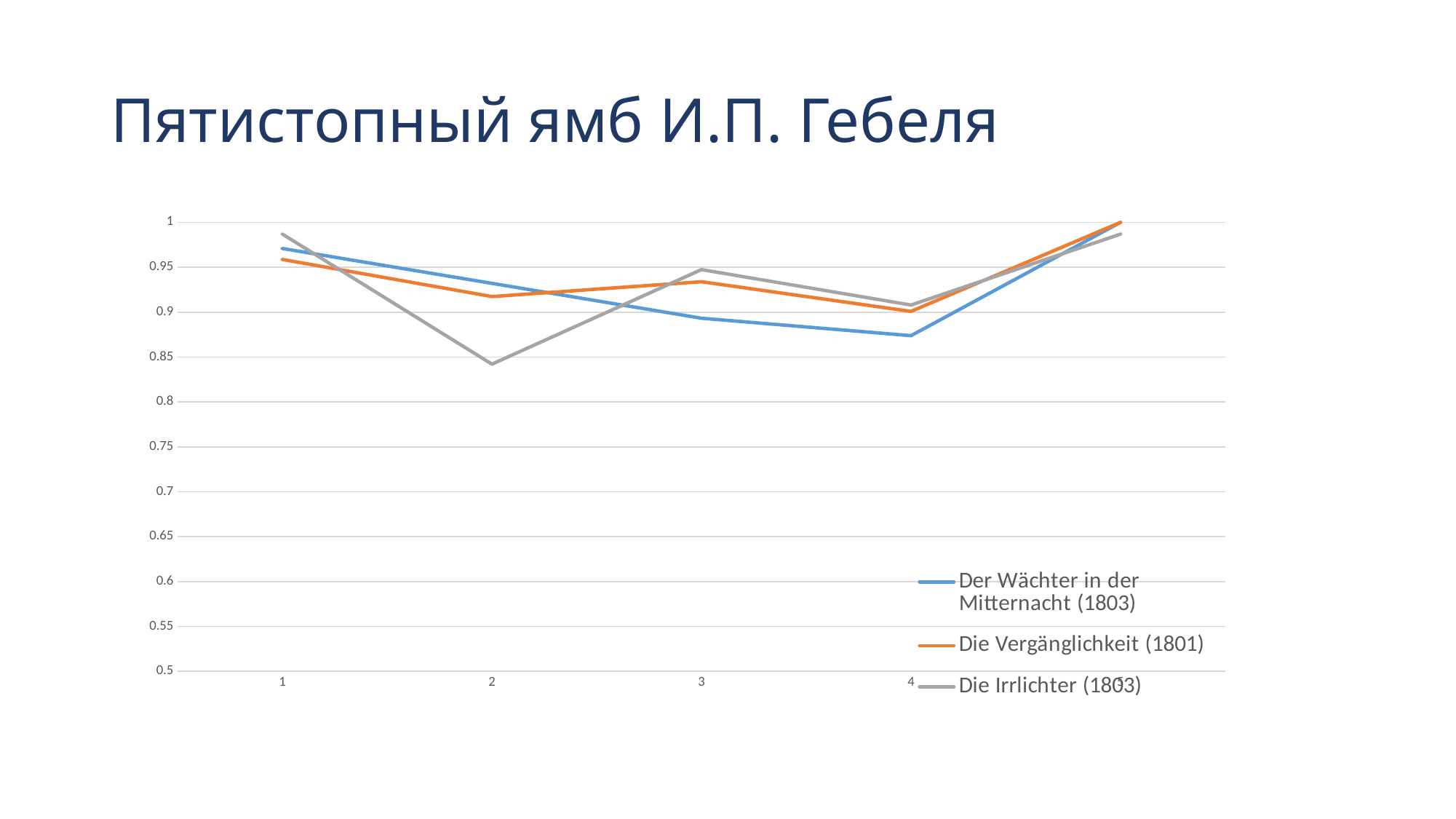
Is the value for Die Irrlichter (1803) at position 2 greater or less than 0.85? less How many series does the legend list? 3 What is the title of the slide above the chart? Пятистопный ямб И.П. Гебеля Is the value for Der Wächter in der Mitternacht (1803) at position 4 greater or less than 0.9? less At position 3, which series is higher: Die Irrlichter (1803) or Der Wächter in der Mitternacht (1803)? Die Irrlichter (1803) Is the value for Die Irrlichter (1803) at position 1 greater or less than 0.95? greater At which position does the Der Wächter in der Mitternacht (1803) series reach its lowest value? 4 Which series has the lowest value at position 2? Die Irrlichter (1803) Which colour is used for the series Die Irrlichter (1803)? gray Does the Der Wächter in der Mitternacht (1803) line rise or fall from position 1 to position 4? fall What kind of chart is shown on the slide? line chart